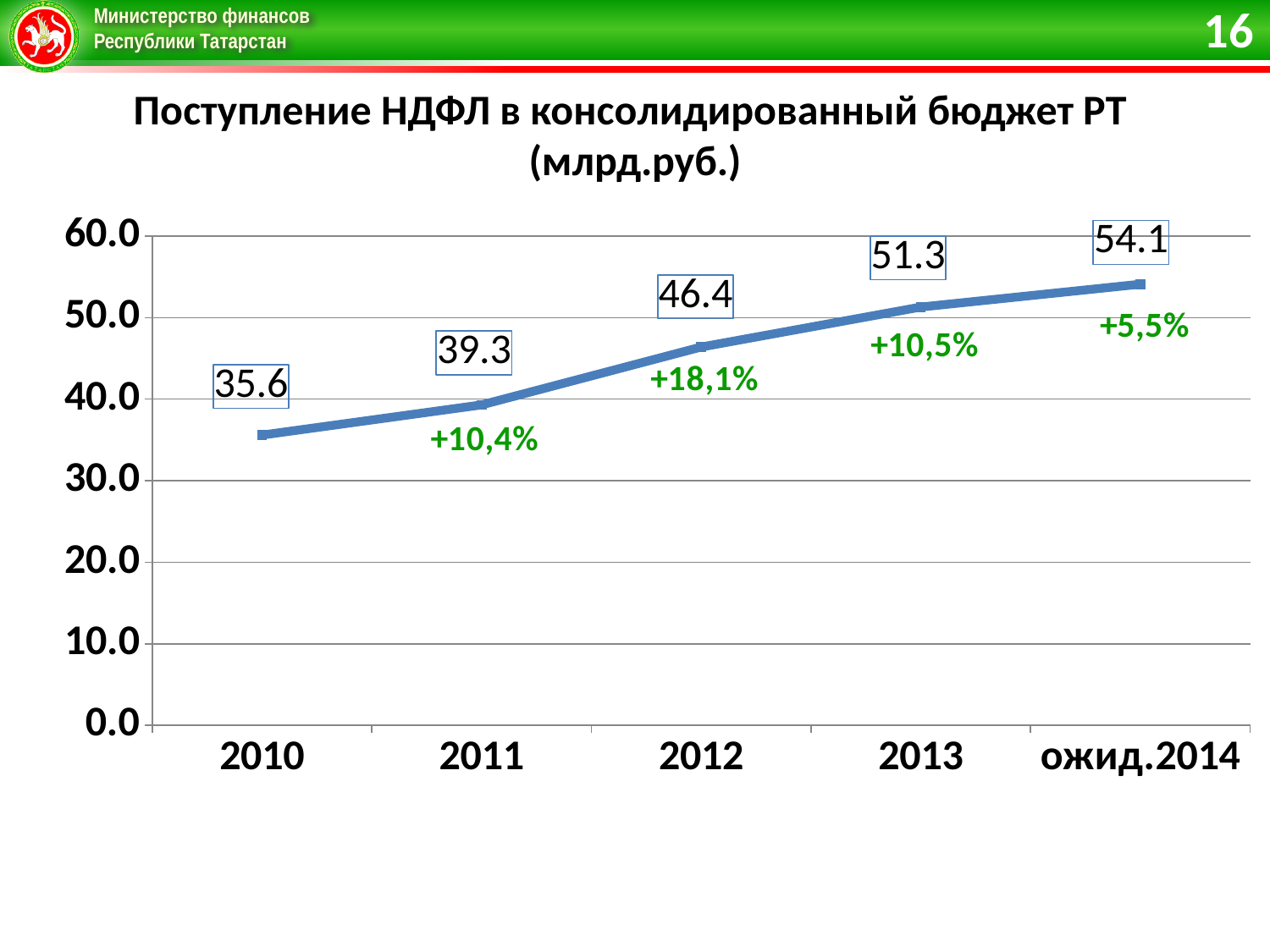
What kind of chart is shown? line chart Which year has the highest value? ожид.2014 Do the values rise or fall from 2010 to ожид.2014? rise What is the value for 2012? 46.4 What is the value for 2010? 35.6 What is the value for ожид.2014? 54.1 What percentage growth is shown between 2011 and 2012? +18,1% Which year has the lowest value? 2010 How many points are plotted on the line? 5 Is the value for 2012 greater or less than 40.0? greater Which is larger, the value for 2011 or the value for 2013? 2013 What is the difference between the values for 2013 and 2012? 4.9